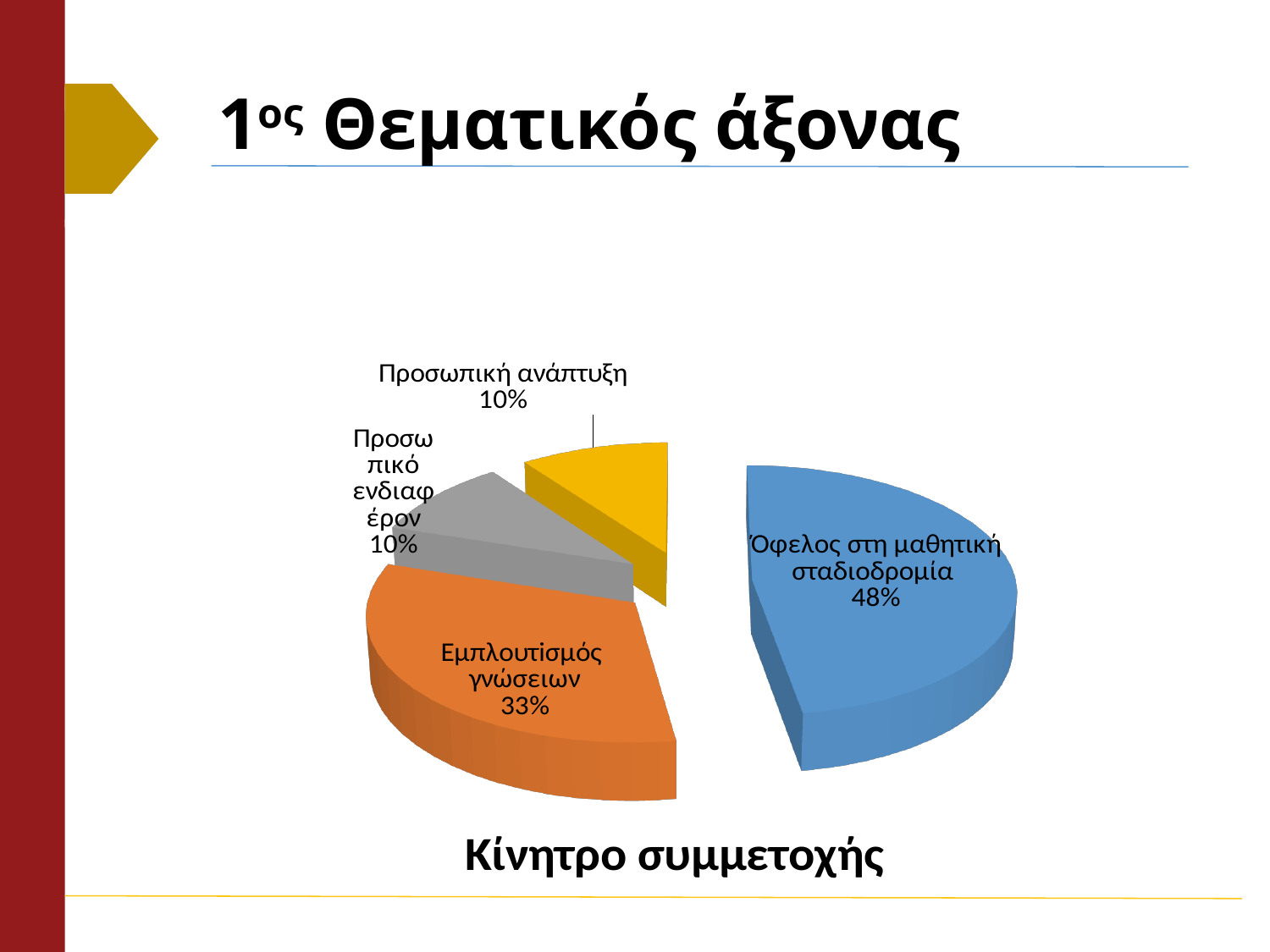
What share of the pie does 'Όφελος στη μαθητική σταδιοδρομία' represent? 48% What kind of chart is shown on the slide? Pie chart What colour is the slice for 'Όφελος στη μαθητική σταδιοδρομία'? Blue How many slices does the pie chart have? 4 What share of the pie does 'Προσωπική ανάπτυξη' represent? 10% What is the combined share of 'Προσωπικό ενδιαφέρον' and 'Προσωπική ανάπτυξη'? 20% What share of the pie does 'Προσωπικό ενδιαφέρον' represent? 10% What is the title of the chart? Κίνητρο συμμετοχής Which has a larger share: 'Εμπλουτισμός γνώσεων' or 'Προσωπική ανάπτυξη'? Εμπλουτισμός γνώσεων Which category has the largest share of the pie? Όφελος στη μαθητική σταδιοδρομία What is the difference in percentage points between 'Όφελος στη μαθητική σταδιοδρομία' and 'Εμπλουτισμός γνώσεων'? 15 percentage points